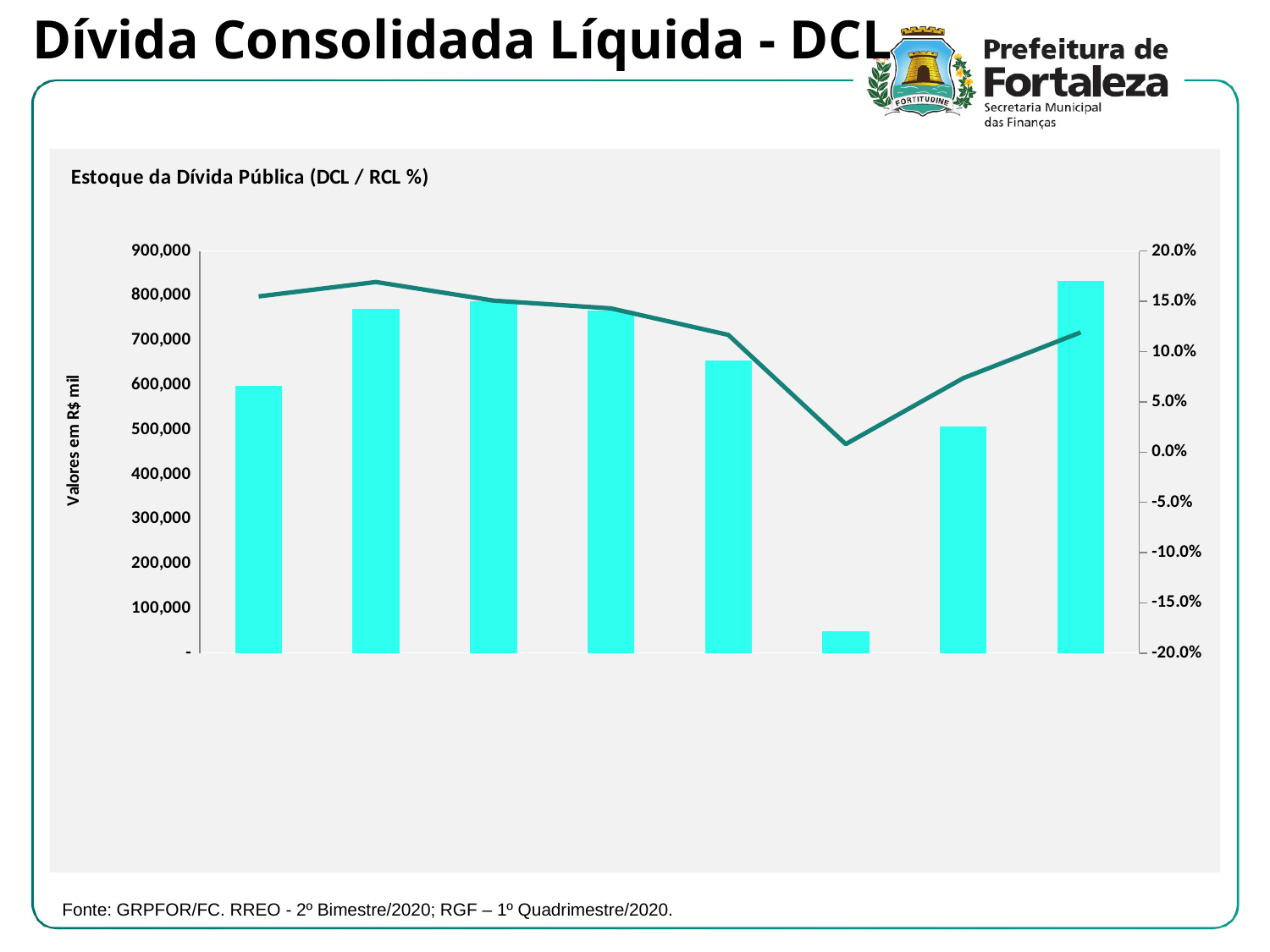
Which is taller, the first bar from the left or the fifth bar from the left? The fifth bar Is the value of the rightmost bar greater or less than 800,000? greater What kind of chart is shown on the slide? A bar chart combined with a line Which bar is the tallest in the chart? The rightmost (eighth) bar How many bars are plotted in the chart? 8 Is the value of the first bar from the left greater or less than 500,000? greater At which point along the x axis does the line series reach its lowest value? The sixth point from the left Is the value of the seventh bar from the left greater or less than 600,000? less Which bar is the shortest in the chart? The sixth bar from the left Does the line series mainly fall or rise between the second and sixth points? Fall What is the title of the chart? Estoque da Dívida Pública (DCL / RCL %)